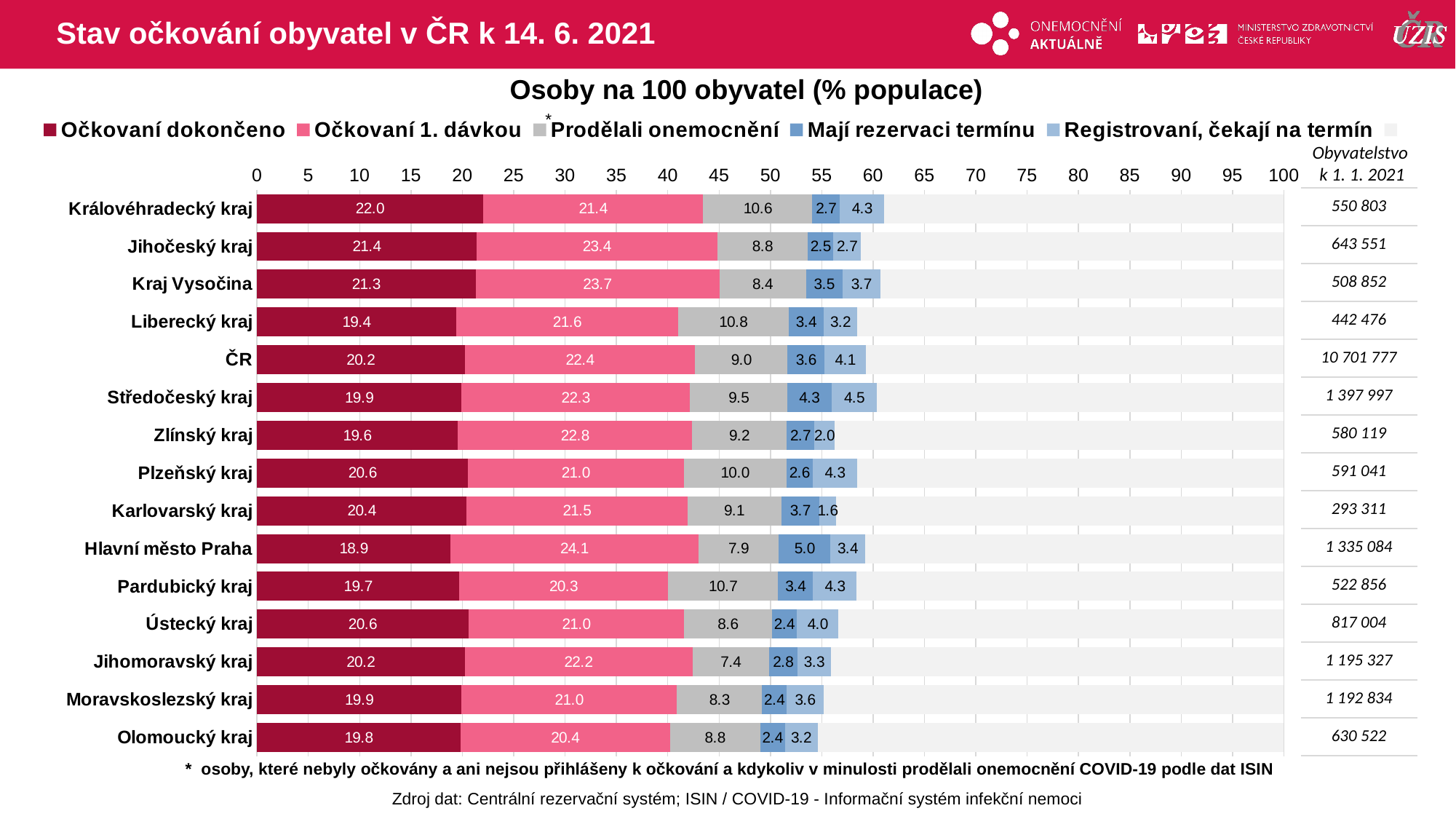
What is the difference between the Očkovaní 1. dávkou values for Kraj Vysočina and Pardubický kraj? 3.4 What is the value of Mají rezervaci termínu for Hlavní město Praha? 5.0 Which category has the highest value for Očkovaní dokončeno? Královéhradecký kraj What is the value of Očkovaní dokončeno for Královéhradecký kraj? 22.0 What is the value of Očkovaní 1. dávkou for Hlavní město Praha? 24.1 Which category has the lowest value for Očkovaní dokončeno? Hlavní město Praha What is the title of the chart? Osoby na 100 obyvatel (% populace) What is the value of Prodělali onemocnění for Liberecký kraj? 10.8 What is the value of Registrovaní, čekají na termín for Středočeský kraj? 4.5 What is the total of the labelled segments in the bar for Královéhradecký kraj? 61.0 How many categories (rows) are shown in the chart? 15 Which has the larger Prodělali onemocnění value, Pardubický kraj or Jihomoravský kraj? Pardubický kraj